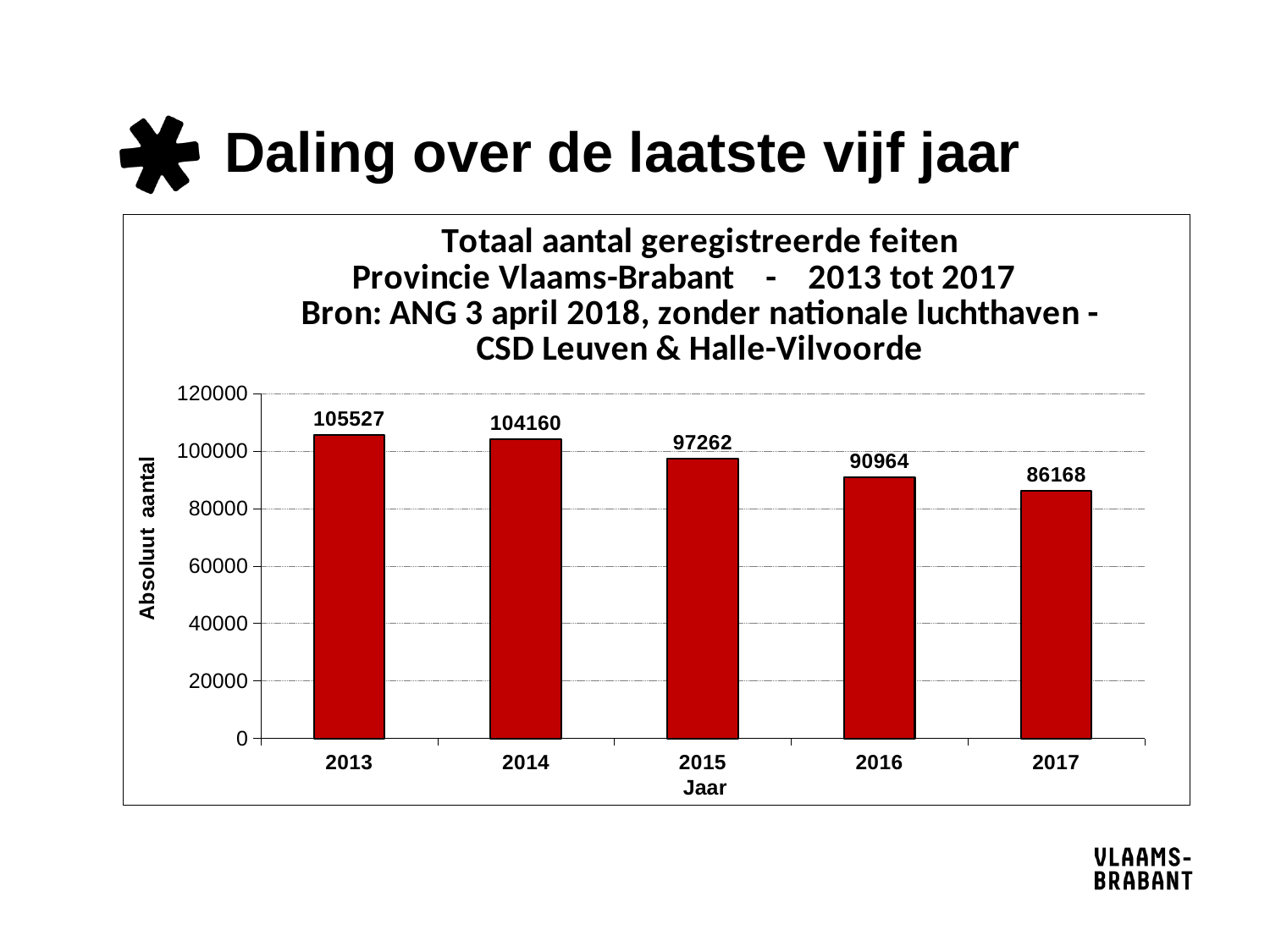
Do the values rise or fall from 2013 to 2017? fall What is the difference between the values for 2015 and 2016? 6298 What is the value for 2017? 86168 What is the value for 2013? 105527 How many years are shown on the x axis? 5 Is the value for 2016 greater or less than 100000? less Which year has the lowest value? 2017 Which year has the highest value? 2013 What is the value for 2015? 97262 Which is larger, the value for 2014 or the value for 2016? 2014 What kind of chart is shown? bar chart What is the difference between the values for 2013 and 2017? 19359